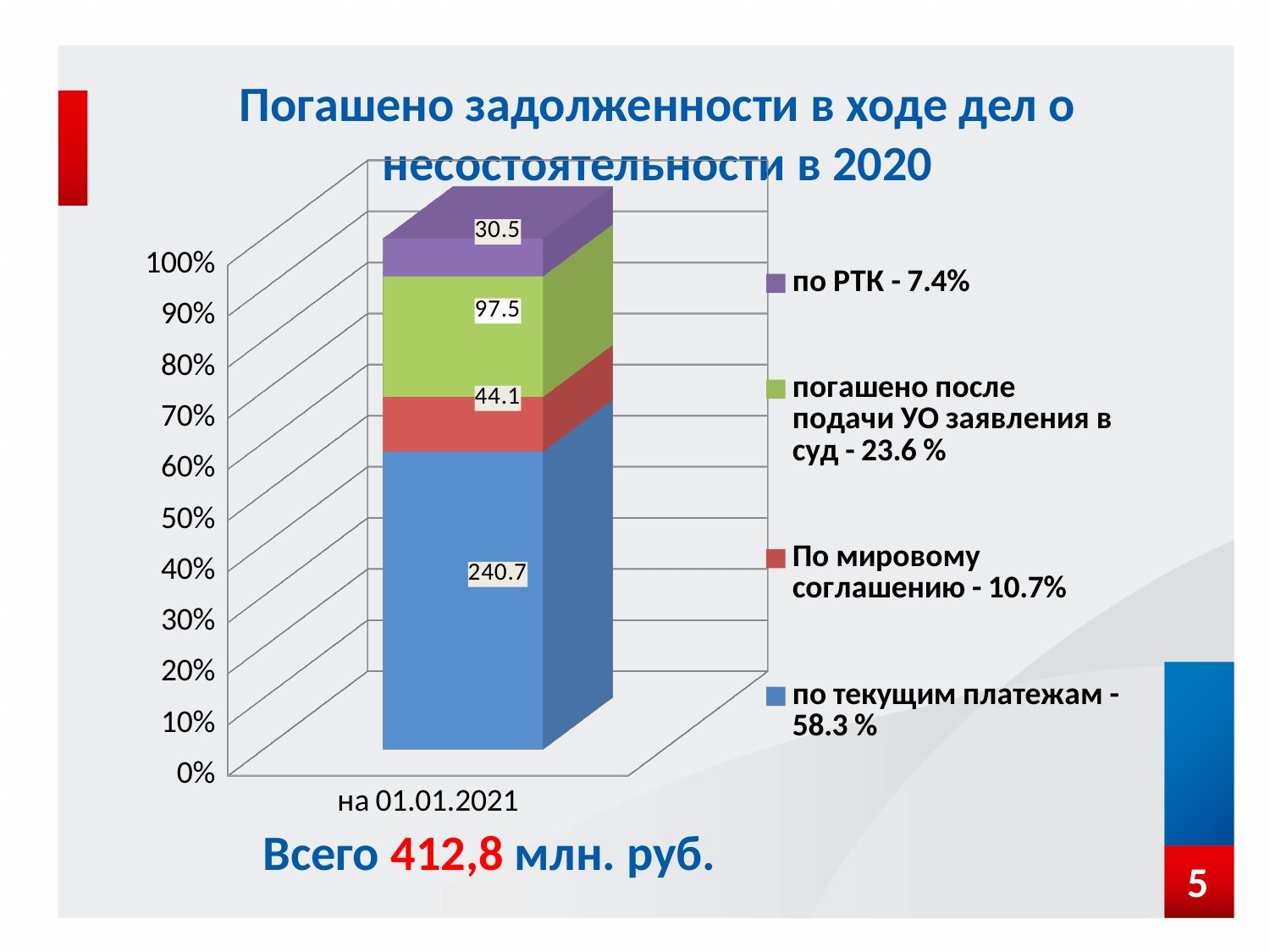
What is the value of the 'По мировому соглашению' segment? 44.1 What is the value of the 'по РТК' segment in the stacked bar? 30.5 Which segment of the stacked bar has the smallest value? по РТК What kind of chart is shown on the slide? Stacked bar chart What is the difference between the 'по текущим платежам' segment and the 'погашено после подачи УО заявления в суд' segment? 143.2 What is the value of the 'погашено после подачи УО заявления в суд' segment? 97.5 What is the value of the 'по текущим платежам' segment in the stacked bar? 240.7 What percentage share does the legend give for 'по текущим платежам'? 58.3 % How many series does the legend list? 4 What is the total of all segments in the stacked bar? 412.8 Which segment of the stacked bar has the largest value? по текущим платежам Which is larger: the 'По мировому соглашению' segment or the 'по РТК' segment? По мировому соглашению